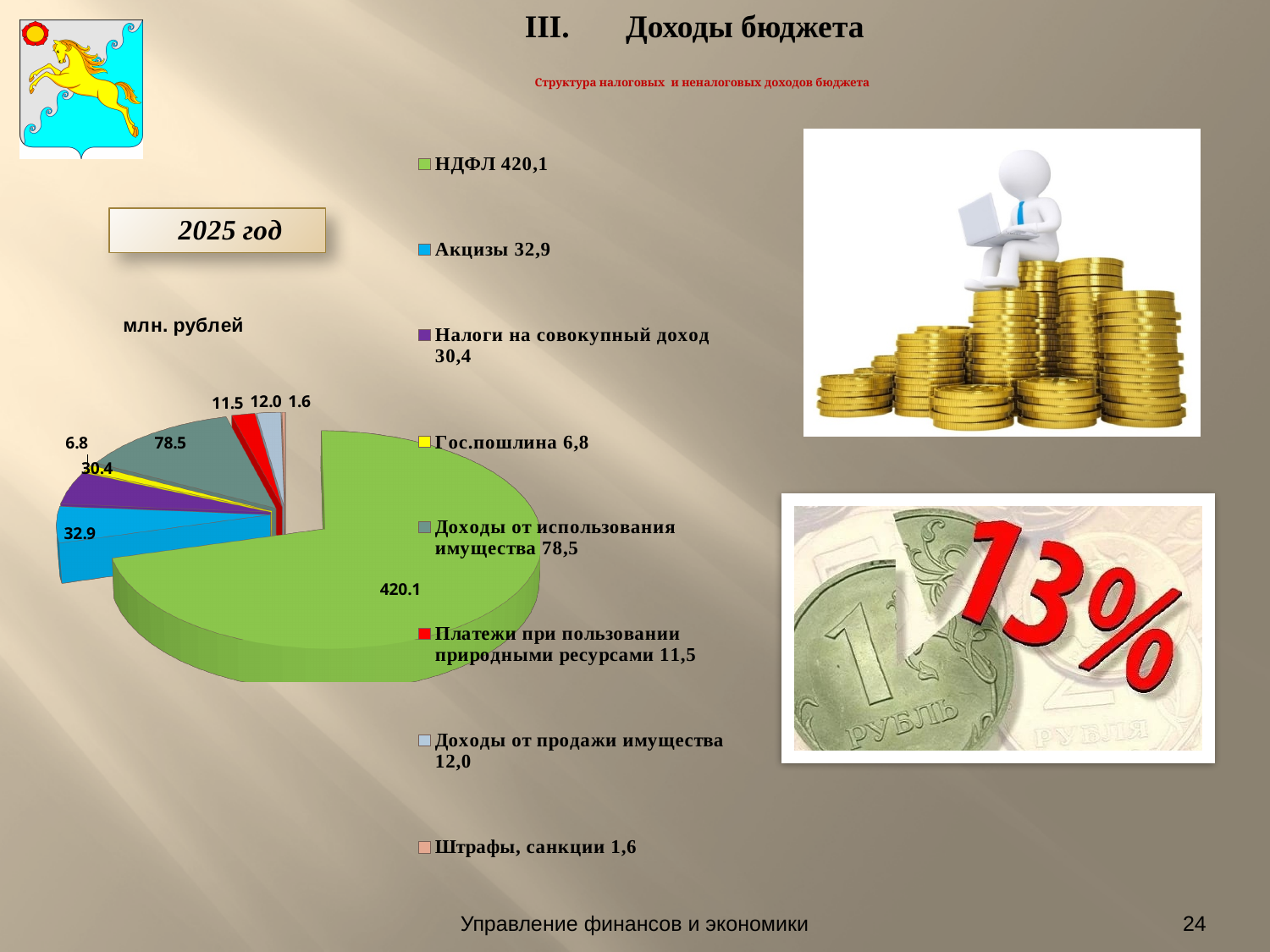
Which category has the smallest slice of the pie? Штрафы, санкции What unit is stated above the pie chart? млн. рублей What is the value for НДФЛ in the pie chart? 420.1 Which category has the largest slice of the pie? НДФЛ What is the value for Доходы от использования имущества? 78.5 What is the value for Штрафы, санкции? 1.6 Which is larger: Акцизы or Налоги на совокупный доход? Акцизы What type of chart is shown on the slide? Pie chart How many entries does the legend list? 8 How many slices does the pie chart have? 8 What is the value for Акцизы in the pie chart? 32.9 What is the difference between Доходы от использования имущества and Акцизы? 45.6